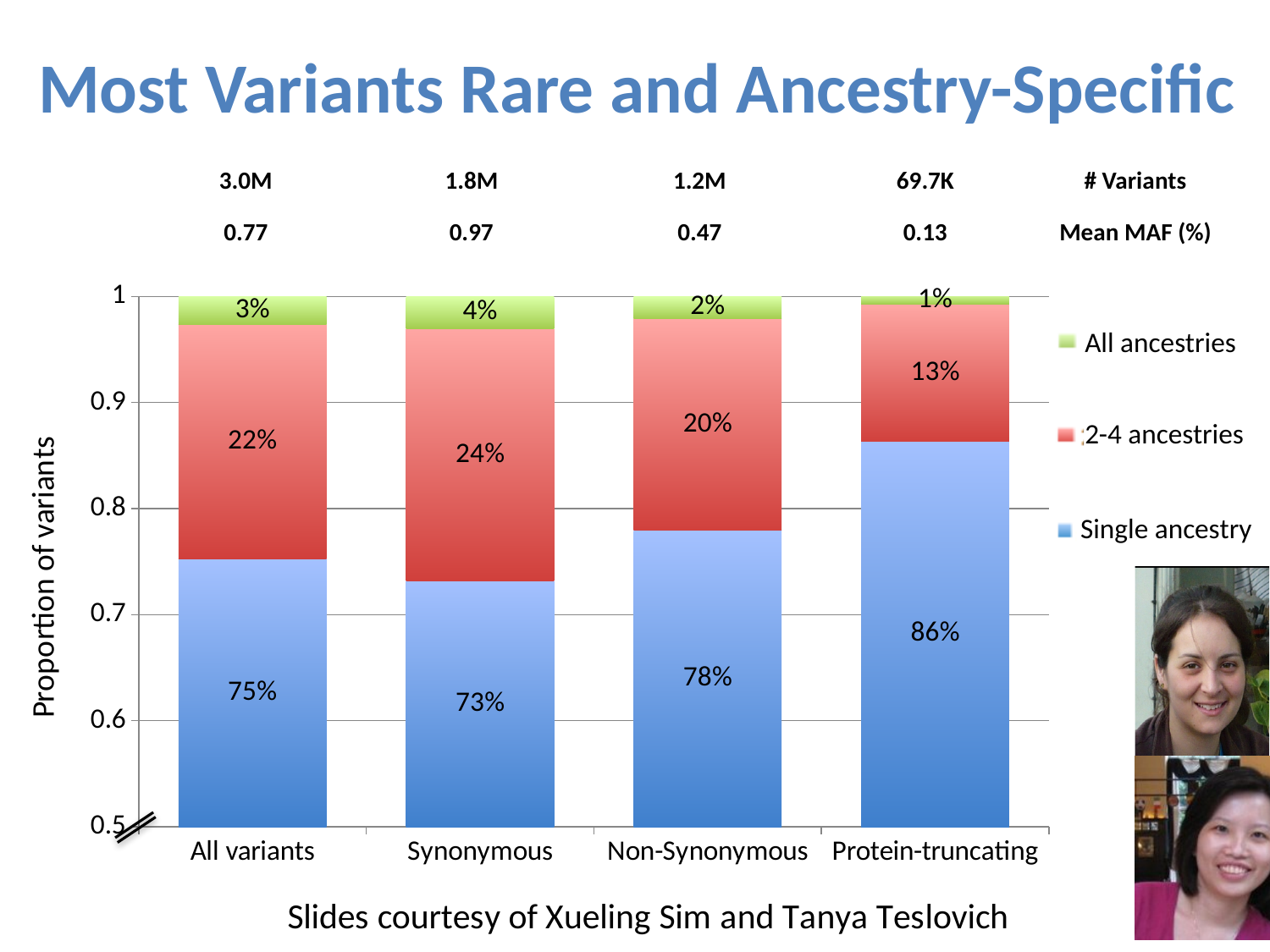
How many categories are shown on the x axis? 4 What is the difference between the Single ancestry percentages for Protein-truncating and Synonymous variants? 13% How many series does the legend list? 3 What percentage of Non-Synonymous variants are found in All ancestries? 2% Which category has the lowest All ancestries percentage? Protein-truncating What is the Single ancestry percentage for All variants? 75% What kind of chart is shown on the slide? Stacked bar chart Which category has the highest Single ancestry percentage? Protein-truncating Which is larger: the 2-4 ancestries percentage for Synonymous or for Non-Synonymous variants? Synonymous What is the label of the y axis? Proportion of variants What percentage of Synonymous variants are Single ancestry? 73% What percentage of Protein-truncating variants are found in 2-4 ancestries? 13%